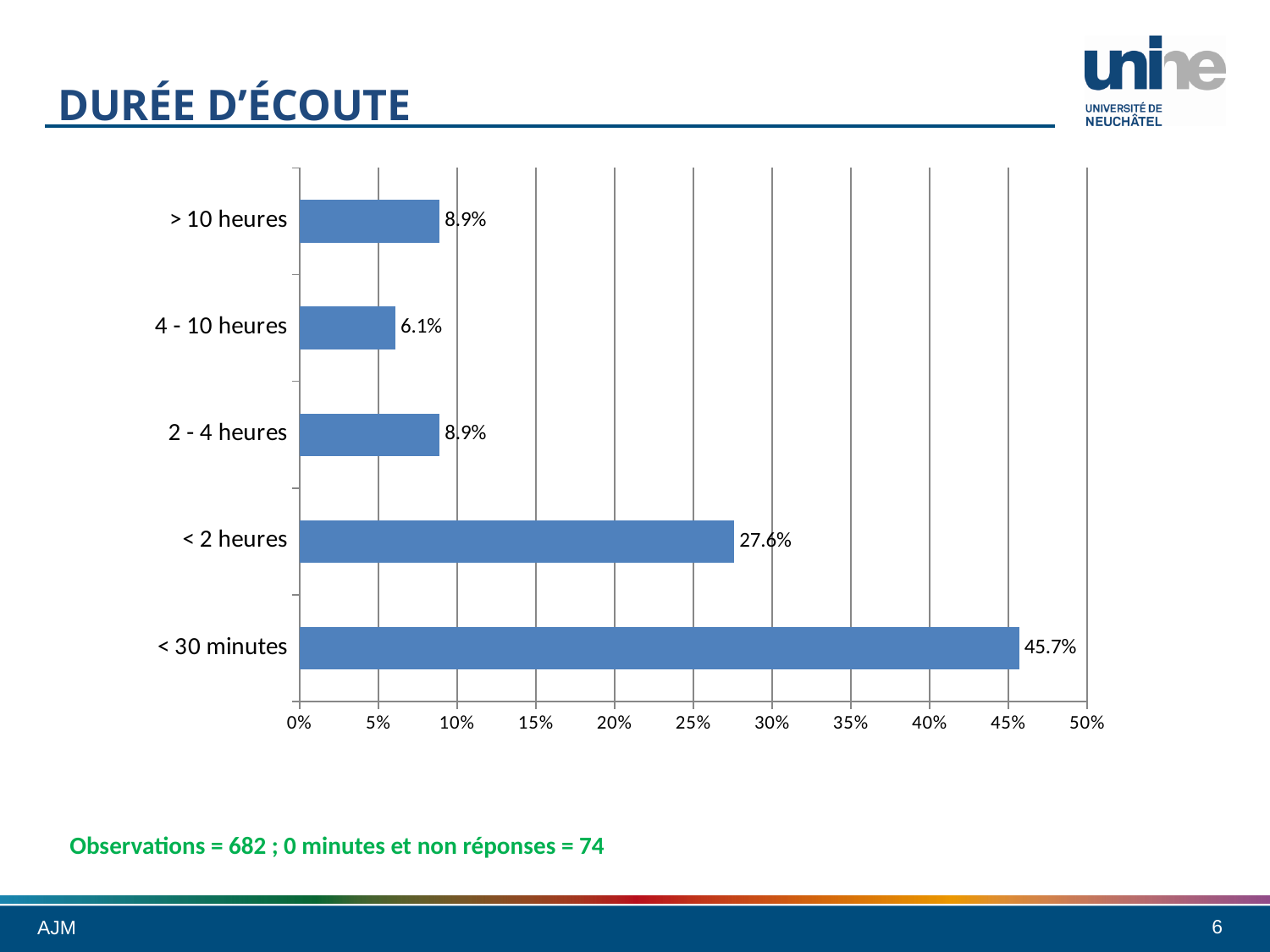
What is the value for "< 30 minutes"? 45.7% Which is larger, the value for "2 - 4 heures" or the value for "4 - 10 heures"? 2 - 4 heures What is the value for "4 - 10 heures"? 6.1% What kind of chart is shown on the slide? bar chart What is the value for "< 2 heures"? 27.6% Which category has the lowest value? 4 - 10 heures Which category has the highest value? < 30 minutes What is the value for "> 10 heures"? 8.9% What is the title of the slide containing the chart? DURÉE D'ÉCOUTE Is the value for "< 2 heures" greater or less than 25%? greater What is the difference between the values for "< 30 minutes" and "< 2 heures"? 18.1% How many categories are shown in the chart? 5